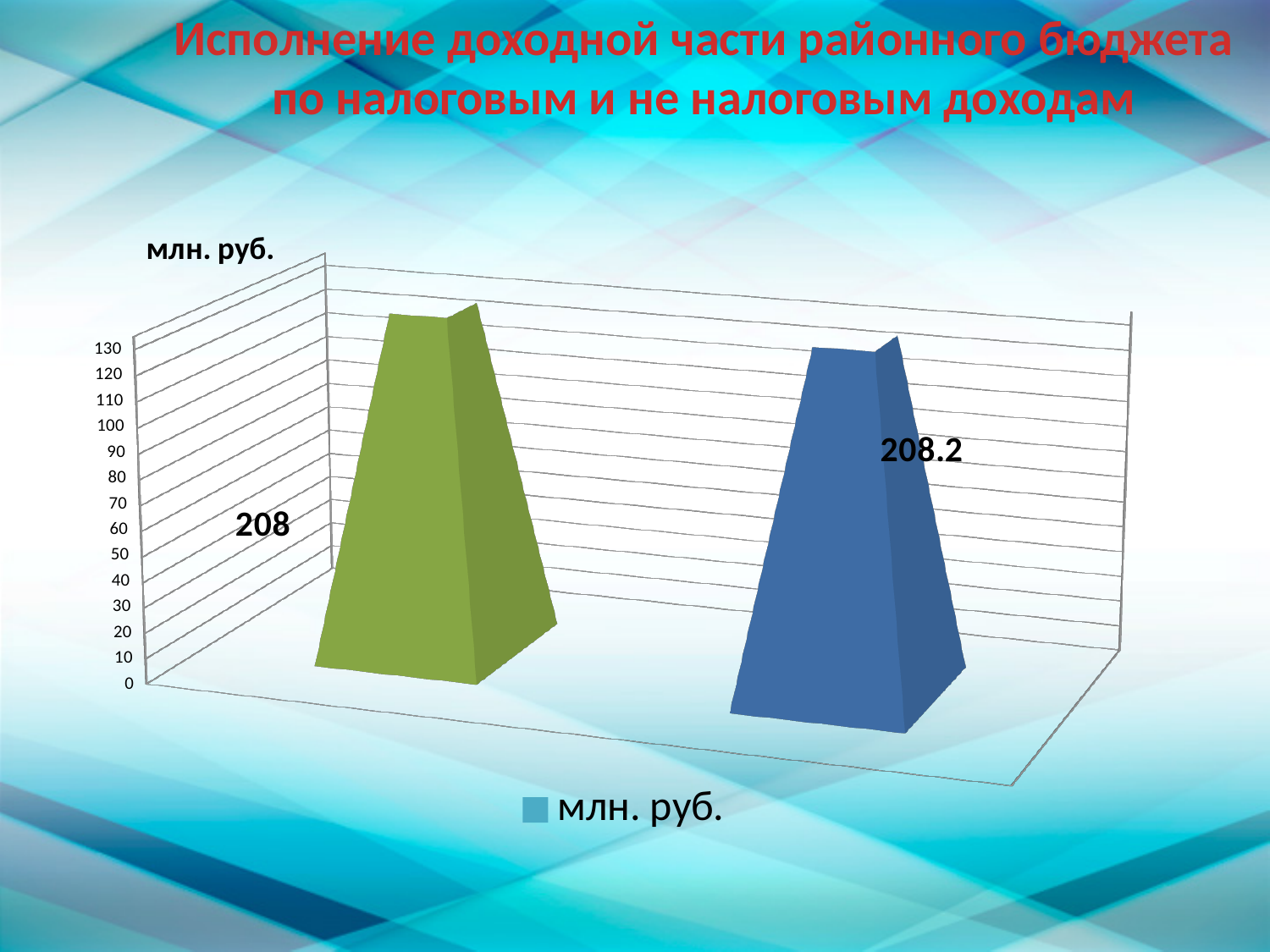
Which bar has the lower printed value, the green one or the blue one? the green bar (208) What is the legend entry of the chart? млн. руб. What value is printed on the green bar? 208 What is the difference between the printed values of the blue bar and the green bar? 0.2 What value is printed on the blue bar? 208.2 What kind of chart is shown on the slide? bar chart How many bars are plotted on the chart? 2 Is the printed value of the blue bar larger or smaller than that of the green bar? larger Which bar has the higher printed value, the green one or the blue one? the blue bar (208.2) What is the highest tick value shown on the vertical axis? 130 How many series does the legend list? 1